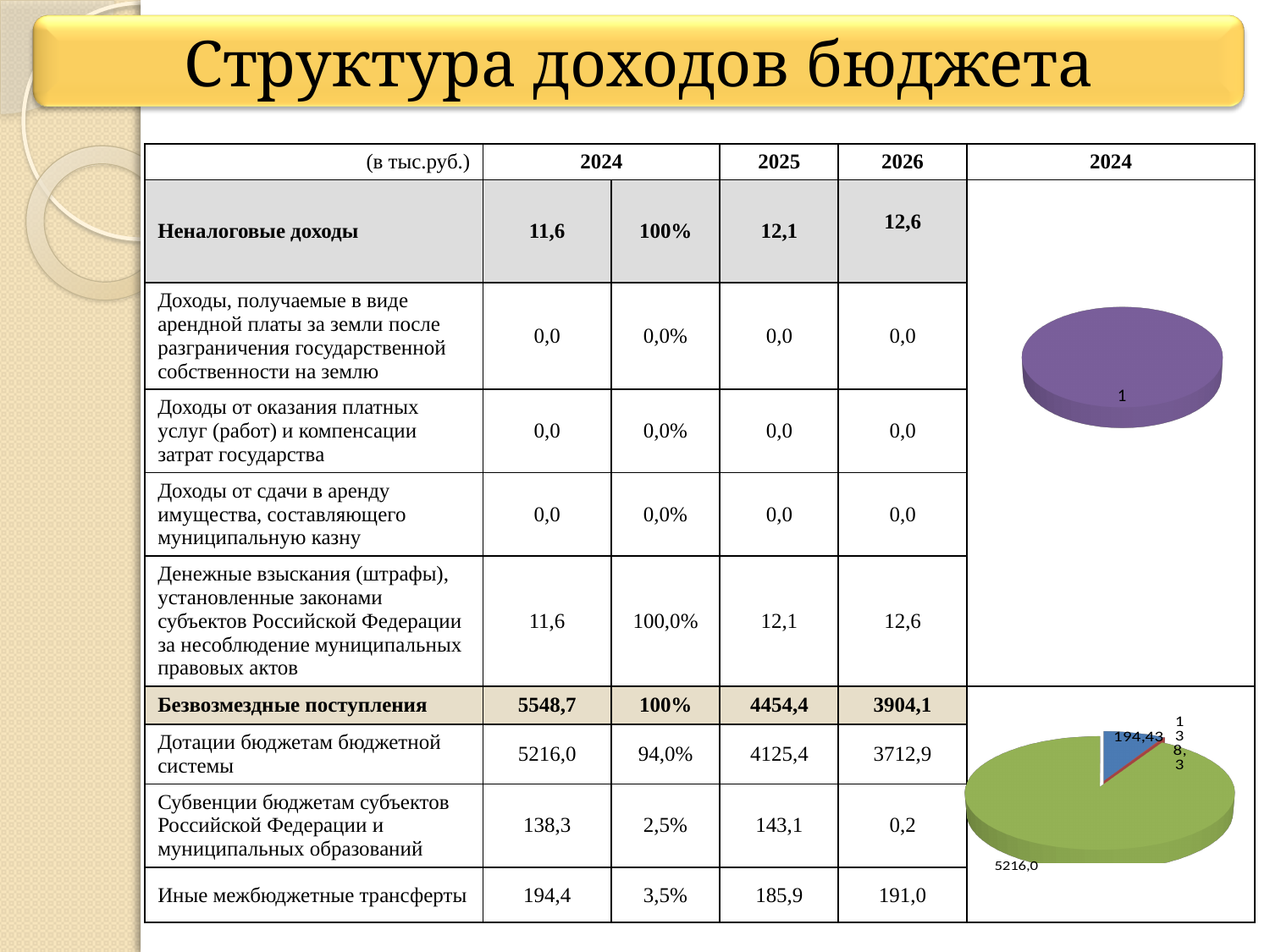
Which year is shown in the column header above the two pie charts? 2024 What kind of chart is the lower chart on the right side of the slide? pie chart In the lower pie chart, what value is printed on the largest slice? 5216,0 What kind of chart is the upper chart on the right side of the slide? pie chart In the lower pie chart, which slice is the largest: the green one or the blue one? the green one In the lower pie chart, what is the value of the largest slice? 5216,0 How many slices does the upper pie chart have? 1 What colour is the largest slice of the lower pie chart? green How many slices does the lower pie chart have? 3 What label is printed on the single slice of the upper pie chart? 1